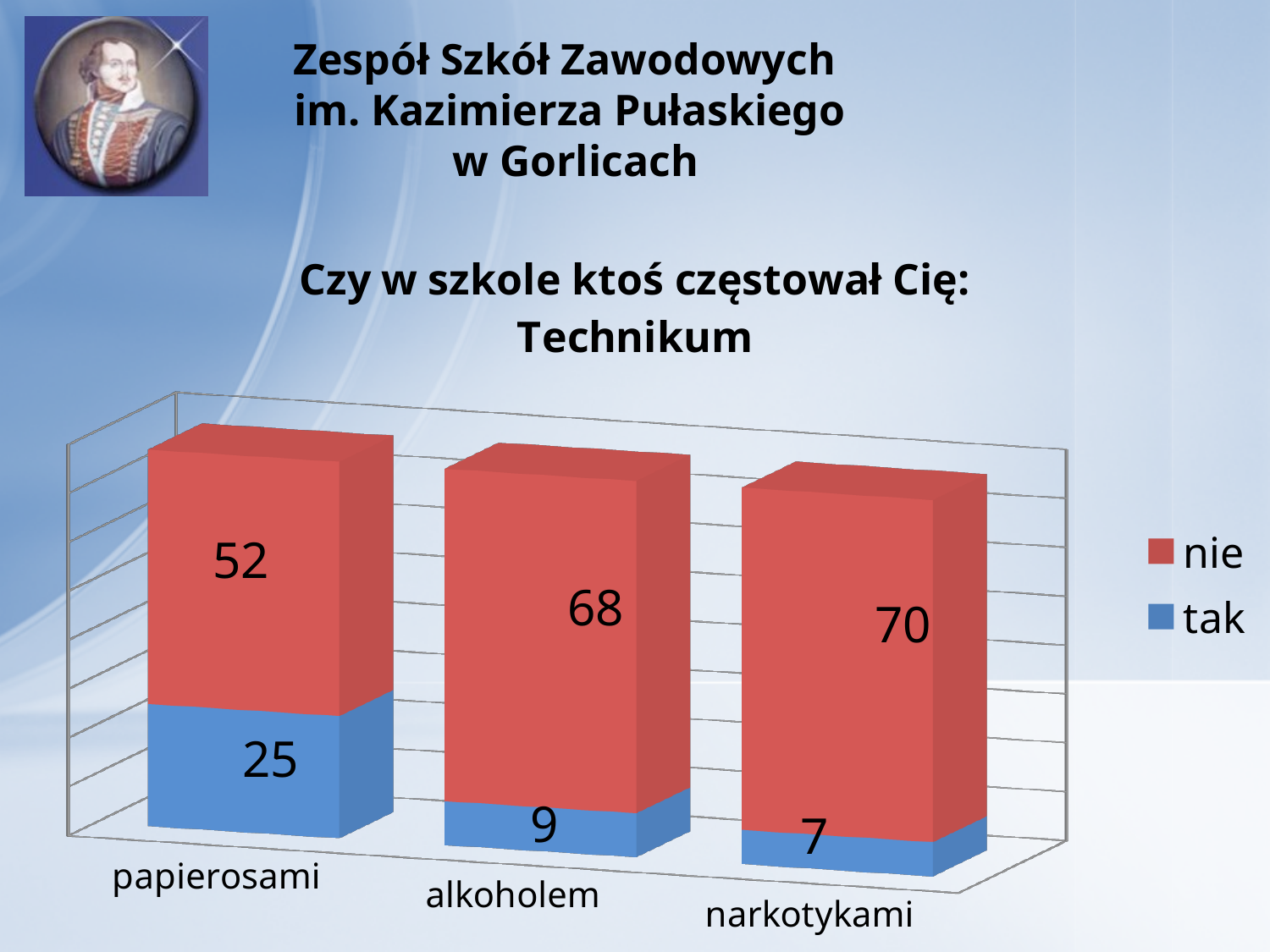
What is the value for "tak" in the papierosami category? 25 What kind of chart is shown on the slide? Stacked bar chart Which category has the lowest "tak" value? narkotykami What is the value for "nie" in the alkoholem category? 68 What is the value for "tak" in the narkotykami category? 7 Which colour represents the "tak" series in the legend? Blue Which is larger: the "tak" value for alkoholem or the "tak" value for papierosami? papierosami Which category has the highest "nie" value? narkotykami What is the total of the stacked bar for alkoholem? 77 How many categories are shown on the x axis? 3 How many series does the legend list? 2 What is the difference between the "nie" and "tak" values for papierosami? 27